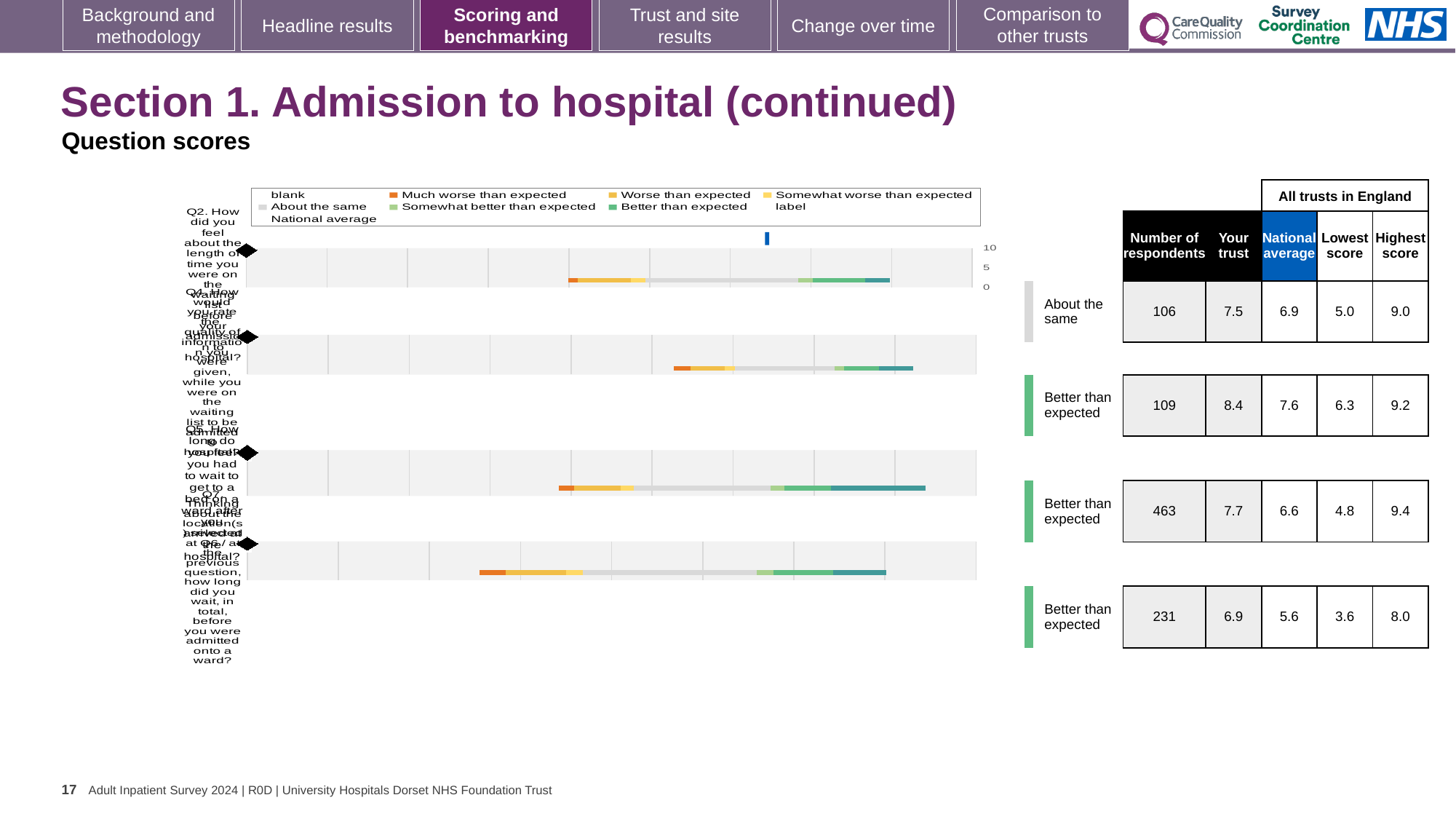
How many rows are rated 'Better than expected'? 3 How many question rows (bars) does the chart show? 4 Which row has the lowest 'Lowest score' value? the fourth row (3.6) What kind of chart is shown on the slide? bar chart Which has the higher 'Your trust' score: the second row (109 respondents) or the third row (463 respondents)? the second row (8.4) What is the highest score for the third row (463 respondents)? 9.4 What is the national average for the second row (rated 'Better than expected')? 7.6 What is the number of respondents for the first row (Q2, rated 'About the same')? 106 For the first row (Q2), how much higher is the 'Your trust' score than the national average? 0.6 What is the maximum value shown on the chart's score axis? 10 What is the 'Your trust' score for the first row (Q2, rated 'About the same')? 7.5 Which row has the highest number of respondents? the third row (463)